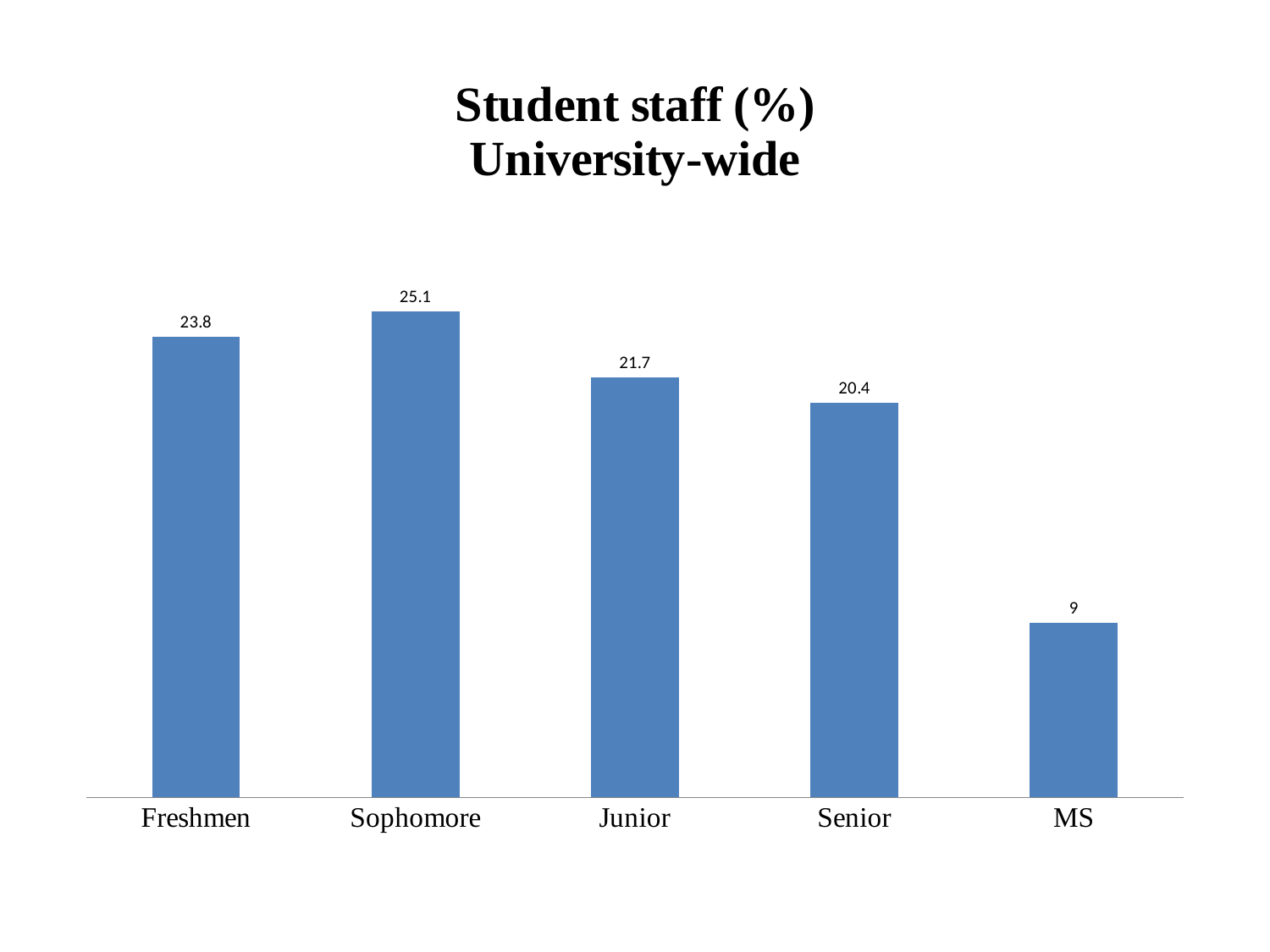
What is the value for MS? 9 What is the value for Senior? 20.4 How many categories are shown on the x axis? 5 Which category has the highest value? Sophomore What is the difference between the values for Senior and MS? 11.4 Which is larger, the value for Junior or the value for Senior? Junior What is the value for Freshmen? 23.8 Which category has the lowest value? MS What is the value for Sophomore? 25.1 What is the value for Junior? 21.7 What is the difference between the values for Sophomore and Freshmen? 1.3 What kind of chart is shown on the slide? Bar chart